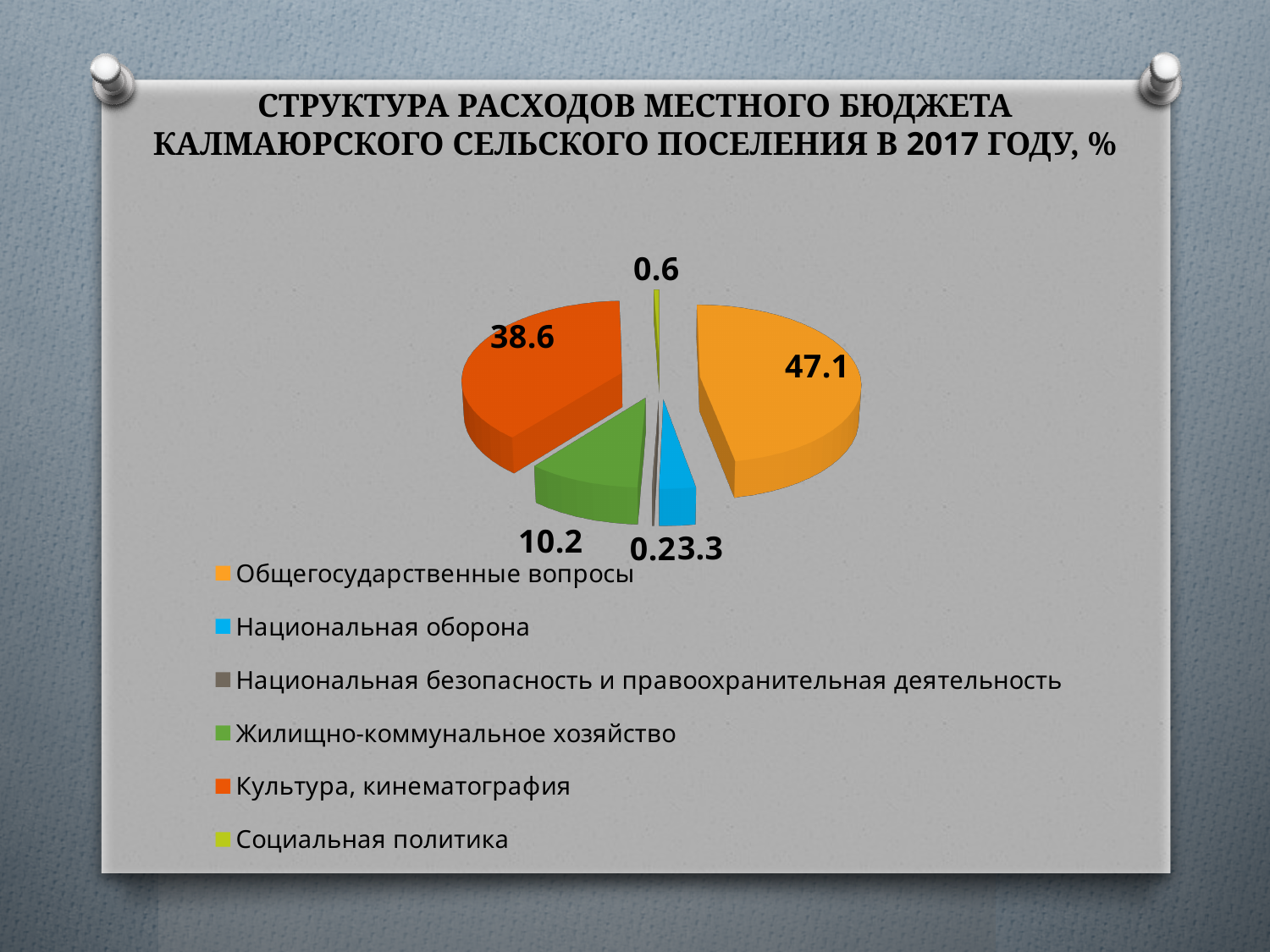
What colour is the slice for Культура, кинематография? red-orange What year does the chart title refer to? 2017 Which is larger: Жилищно-коммунальное хозяйство or Национальная оборона? Жилищно-коммунальное хозяйство Which category has the smallest share of the pie? Национальная безопасность и правоохранительная деятельность What is the difference between the values for Общегосударственные вопросы and Культура, кинематография? 8.5 What type of chart is shown on the slide? pie chart What is the value for Общегосударственные вопросы? 47.1 What is the value for Социальная политика? 0.6 What is the value for Жилищно-коммунальное хозяйство? 10.2 Which category has the largest share of the pie? Общегосударственные вопросы What is the value for Культура, кинематография? 38.6 How many categories does the pie chart have? 6